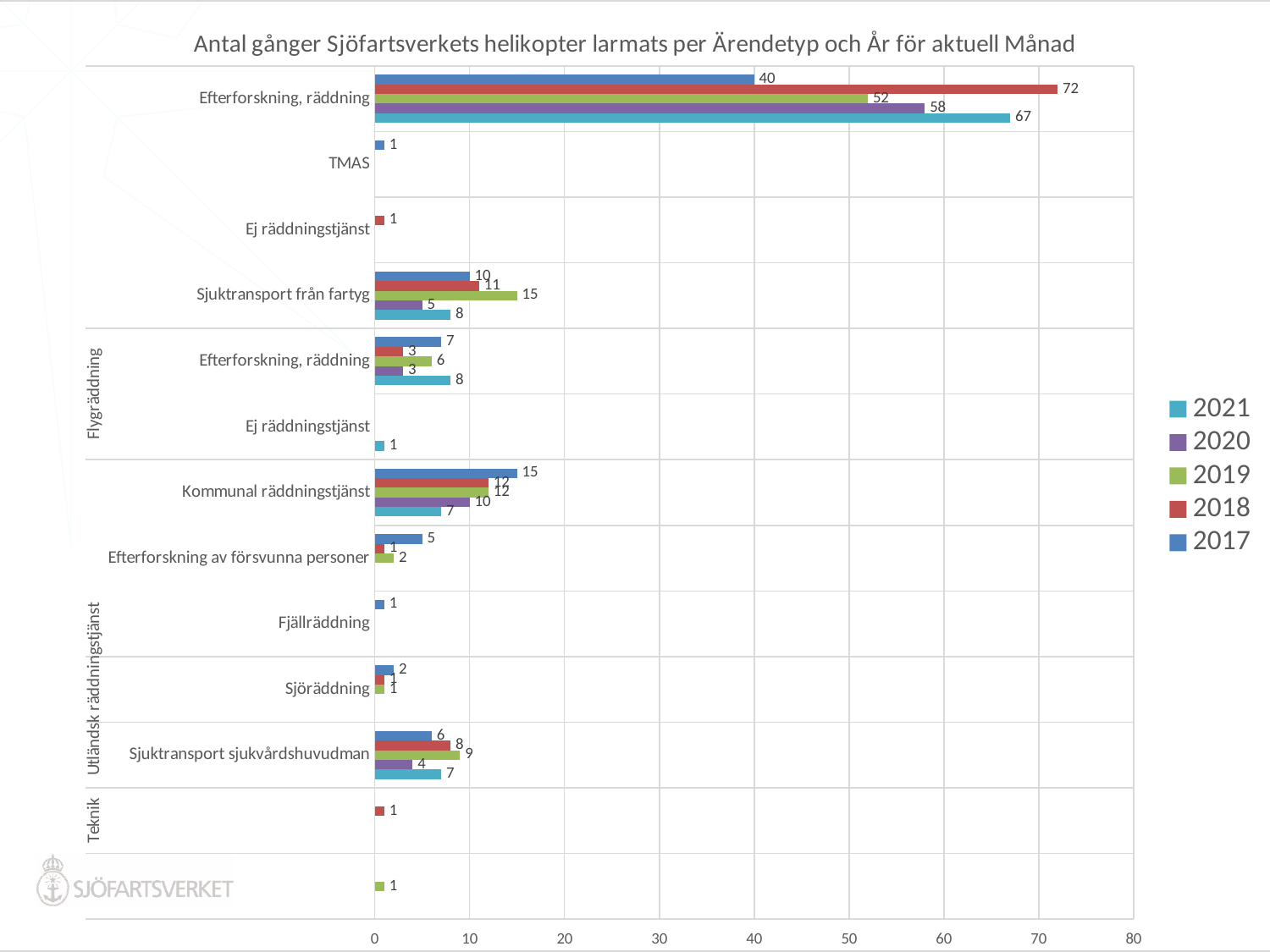
What type of chart is shown on the slide? bar chart What is the difference between the 2018 and 2017 values for the topmost category, Efterforskning, räddning? 32 Which is larger for Kommunal räddningstjänst, the 2017 value or the 2021 value? 2017 Which year is shown in the legend with a purple colour? 2020 Which year has the highest value for the topmost category, Efterforskning, räddning? 2018 What is the 2018 value for the topmost category, Efterforskning, räddning? 72 What is the 2017 value for Efterforskning av försvunna personer? 5 What is the 2019 value for Sjuktransport från fartyg? 15 What is the 2020 value for Sjuktransport sjukvårdshuvudman? 4 How many series does the legend list? 5 Which year has the lowest value for the topmost category, Efterforskning, räddning? 2017 What is the 2021 value for the topmost category, Efterforskning, räddning? 67